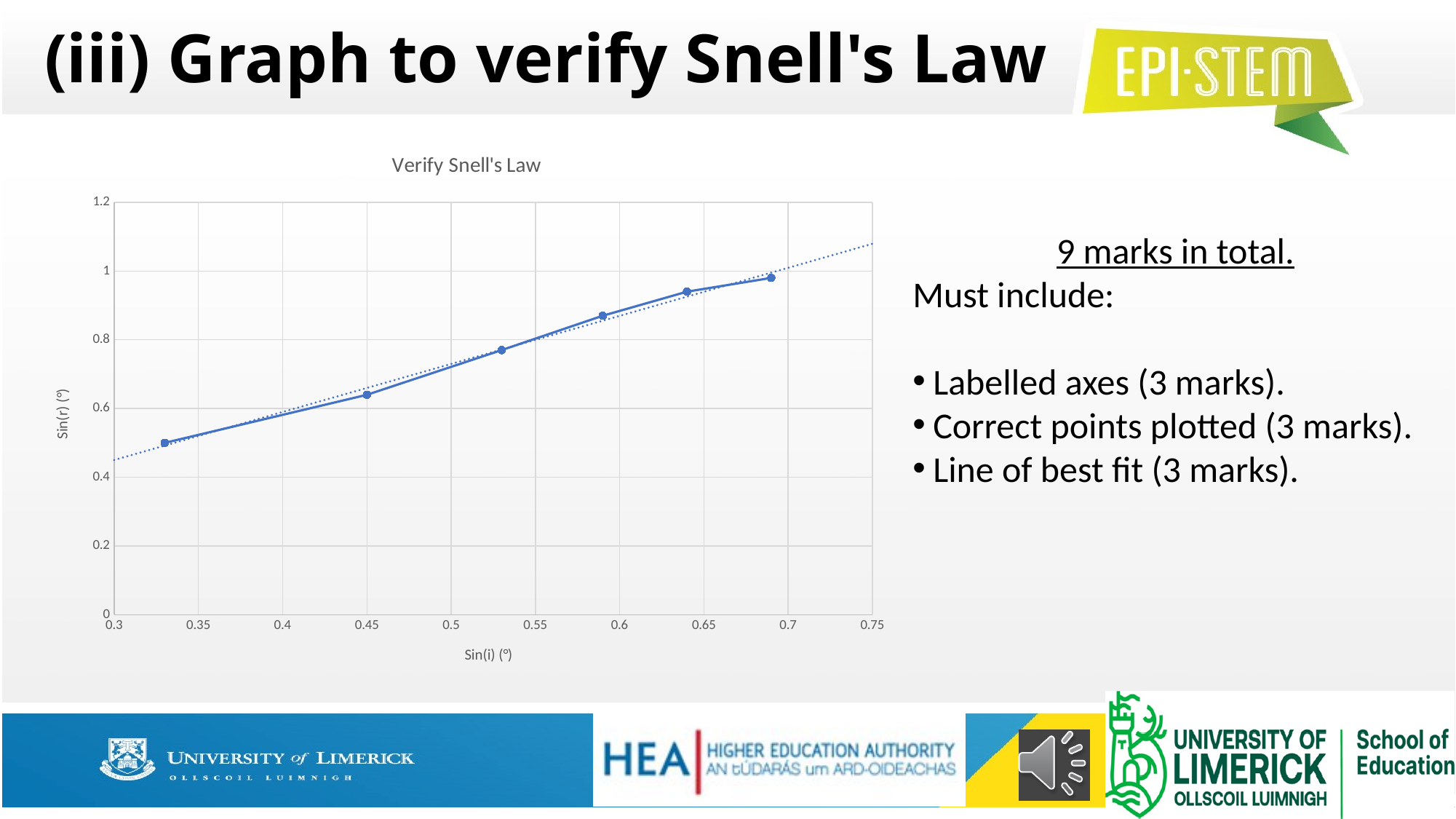
Is the Sin(r) value of the leftmost plotted point greater or less than 0.4? greater What is the title of the chart? Verify Snell's Law What kind of chart is shown on the slide? Line chart Is the Sin(r) value of the point plotted near Sin(i) = 0.59 greater or less than 0.8? greater Is the Sin(r) value of the point plotted near Sin(i) = 0.64 greater or less than 1? less Do the plotted values rise or fall as Sin(i) increases along the x axis? Rise Which plotted point has the highest Sin(r) value, the leftmost or the rightmost? The rightmost How many data points are plotted on the chart? 6 What is the label on the x axis of the chart? Sin(i) (°)